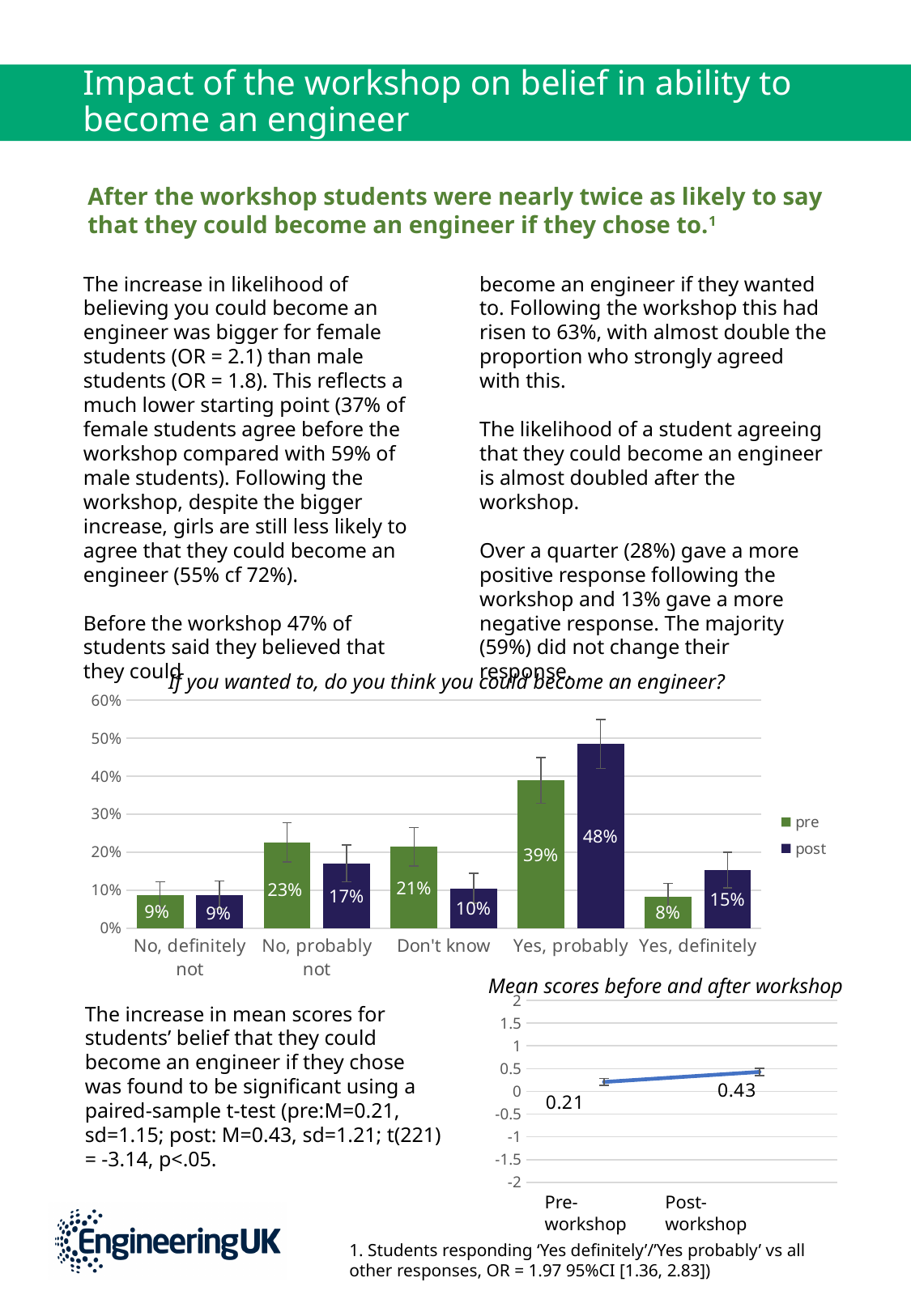
In the chart titled "Mean scores before and after workshop", does the value rise or fall from Pre-workshop to Post-workshop? Rise In the chart titled "If you wanted to, do you think you could become an engineer?", which category has the lowest pre value? Yes, definitely What kind of chart is the one titled "If you wanted to, do you think you could become an engineer?"? Bar chart In the chart titled "If you wanted to, do you think you could become an engineer?", how many series does the legend list? 2 In the chart titled "If you wanted to, do you think you could become an engineer?", what is the difference between the post and pre values for "Yes, definitely"? 7% In the chart titled "If you wanted to, do you think you could become an engineer?", how many response categories are shown on the x axis? 5 In the chart titled "If you wanted to, do you think you could become an engineer?", what is the pre value for "No, probably not"? 23% In the chart titled "If you wanted to, do you think you could become an engineer?", is the pre or post value larger for "Don't know"? pre In the chart titled "Mean scores before and after workshop", what is the value for Post-workshop? 0.43 In the chart titled "Mean scores before and after workshop", what is the difference between the Post-workshop and Pre-workshop values? 0.22 In the chart titled "If you wanted to, do you think you could become an engineer?", which category has the highest post value? Yes, probably In the chart titled "If you wanted to, do you think you could become an engineer?", what is the post value for "Yes, probably"? 48%